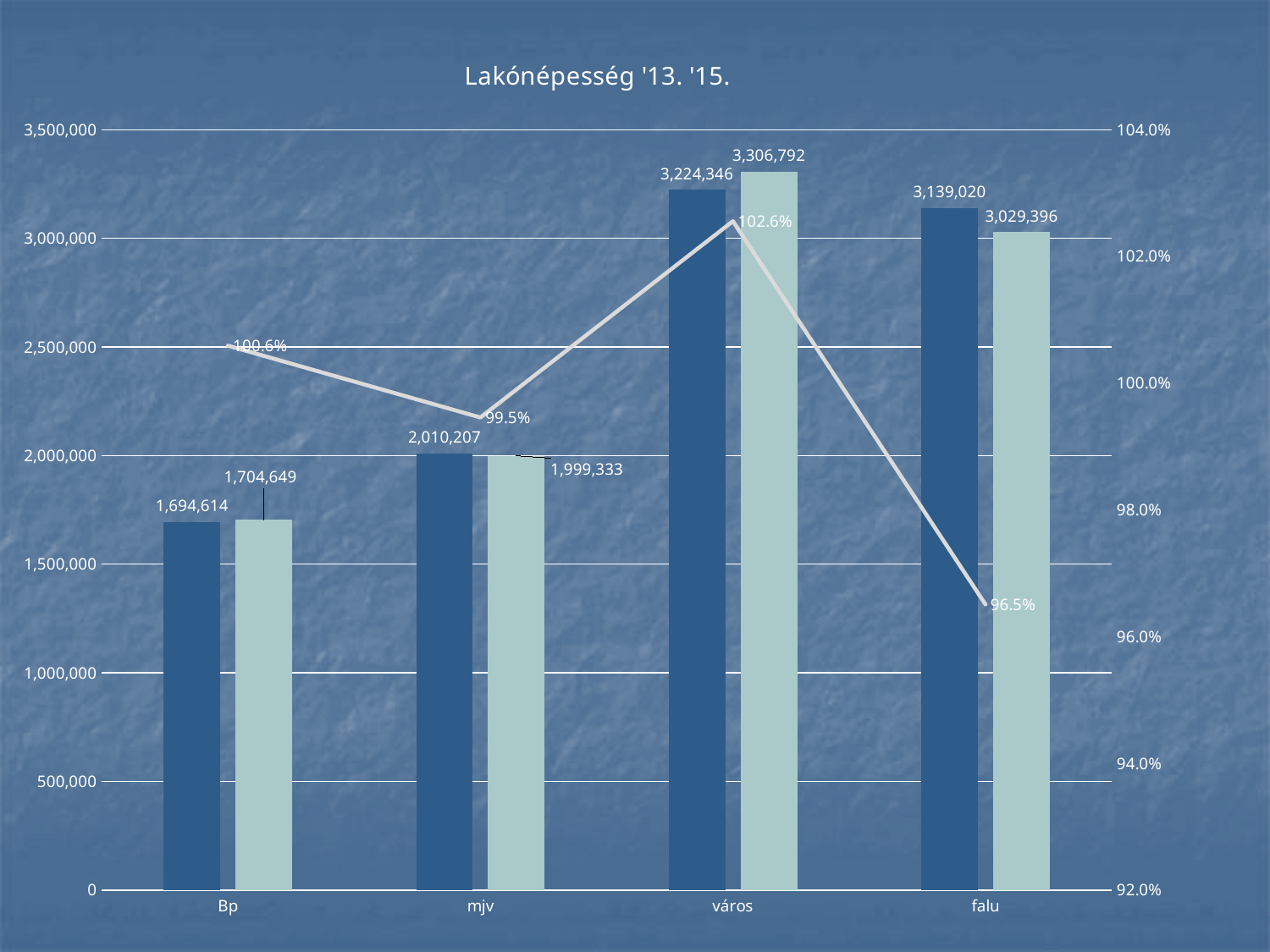
For which category is the line value highest? város What percentage does the line show for falu? 96.5% For which category is the line value lowest? falu What is the title of the chart? Lakónépesség '13. '15. What kind of chart is this? A combined bar and line chart What is the difference between the light bar and the dark blue bar for város? 82,446 What percentage does the line show for mjv? 99.5% What is the value of the light bar for város? 3,306,792 For falu, which is larger: the dark blue bar or the light bar? The dark blue bar (3,139,020) How many categories are shown on the x axis? 4 What is the value of the dark blue bar for Bp? 1,694,614 Is the value of the light bar for Bp greater or less than 1,500,000? greater